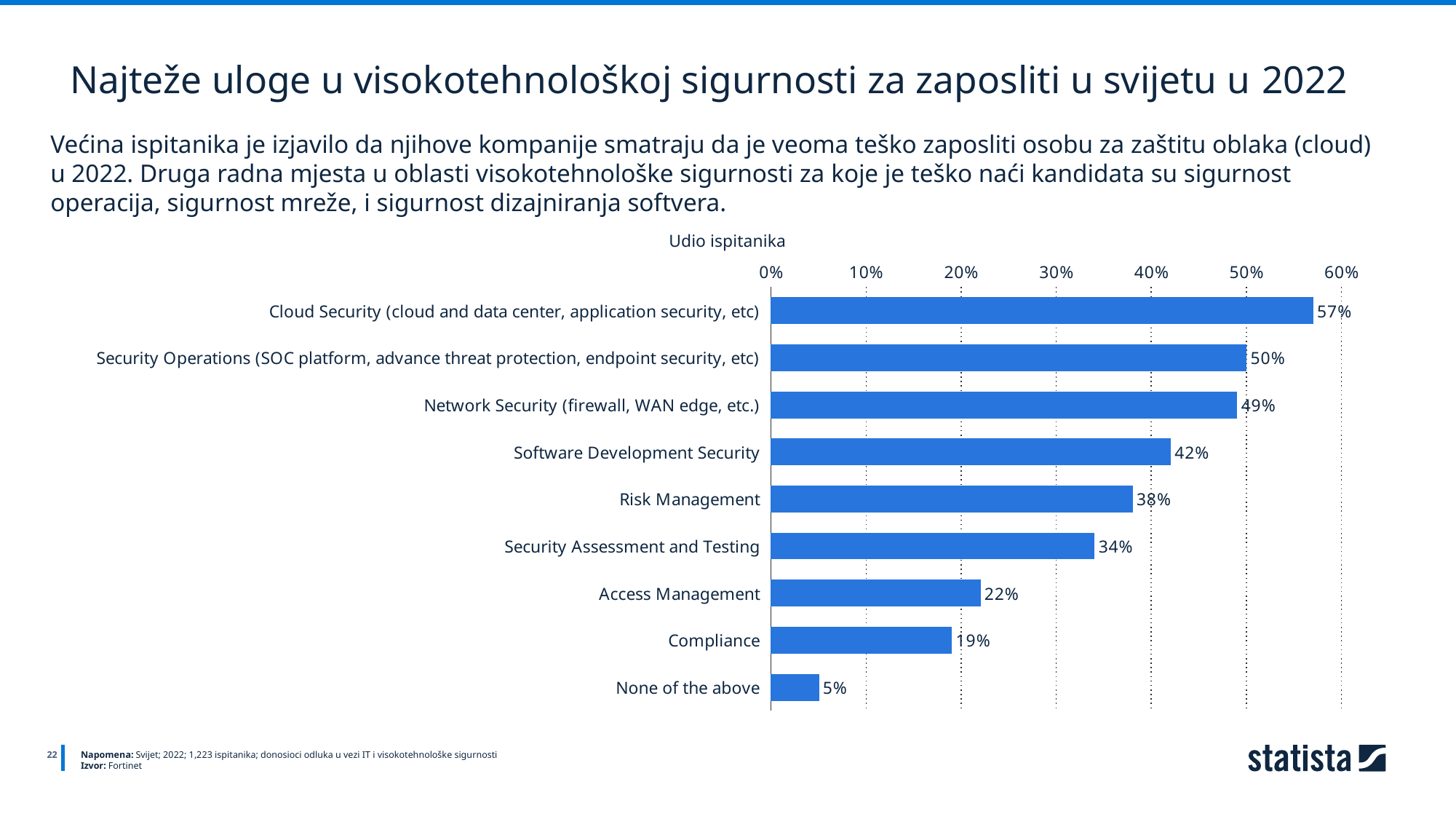
What is the label of the chart's value axis? Udio ispitanika Which category has the lowest value? None of the above What is the difference between the values for Security Operations and Software Development Security? 8% What is the value for Compliance? 19% Is the value for Network Security (firewall, WAN edge, etc.) greater or less than 40%? greater What kind of chart is shown on the slide? bar chart Which category has the highest value? Cloud Security (cloud and data center, application security, etc) What is the value for Risk Management? 38% What is the value for Cloud Security (cloud and data center, application security, etc)? 57% What is the source cited for the chart? Fortinet How many categories are shown in the chart? 9 Which is larger, the value for Security Assessment and Testing or the value for Access Management? Security Assessment and Testing